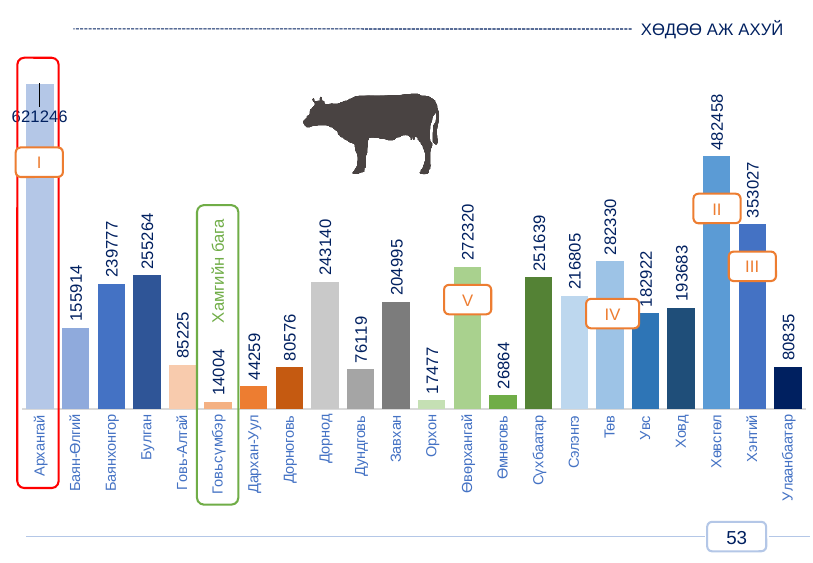
What is the value shown for Хөвсгөл? 482458 What is the difference between the values for Хөвсгөл and Хэнтий? 129431 What is the value shown for Говьсүмбэр? 14004 Which category is marked with the annotation "Хамгийн бага"? Говьсүмбэр Which is larger, the value for Төв or the value for Өвөрхангай? Төв How many categories are shown in the chart? 22 Which is larger, the value for Орхон or the value for Өмнөговь? Өмнөговь What is the value shown for Архангай? 621246 Which category has the lowest value? Говьсүмбэр What kind of chart is shown on the slide? Bar chart What is the value shown for Улаанбаатар? 80835 Which category has the highest value? Архангай